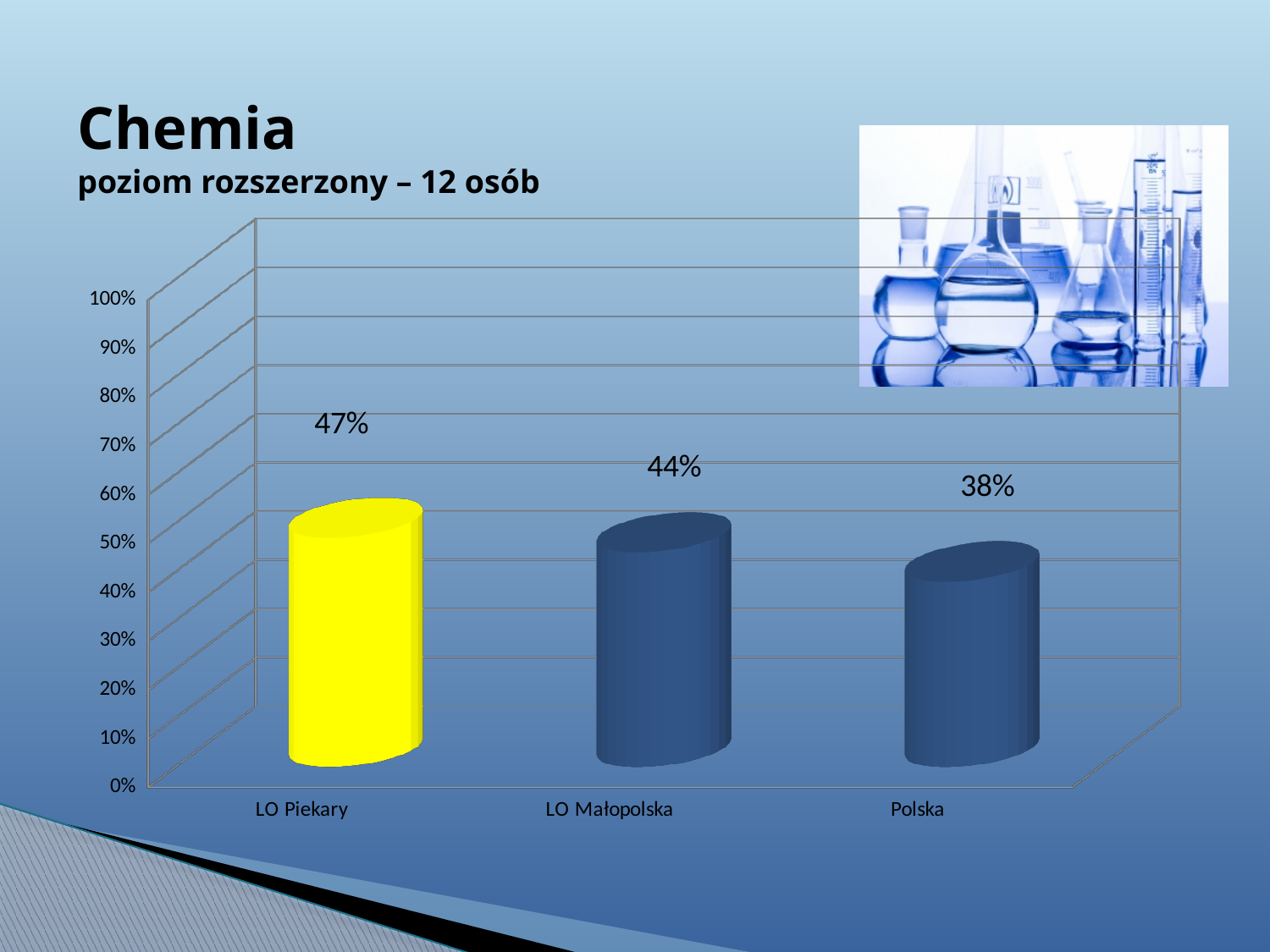
What is the difference between the values for LO Piekary and Polska? 9% What kind of chart is shown on the slide? bar chart Which category has the highest value? LO Piekary Which category has the lowest value? Polska What is the value for LO Małopolska? 44% Is the value for Polska greater or less than 40%? less How many categories are shown on the chart? 3 What is the difference between the values for LO Małopolska and Polska? 6% What is the value for Polska? 38% What is the value for LO Piekary? 47% Which bar is coloured yellow? LO Piekary Which is larger, the value for LO Piekary or the value for LO Małopolska? LO Piekary